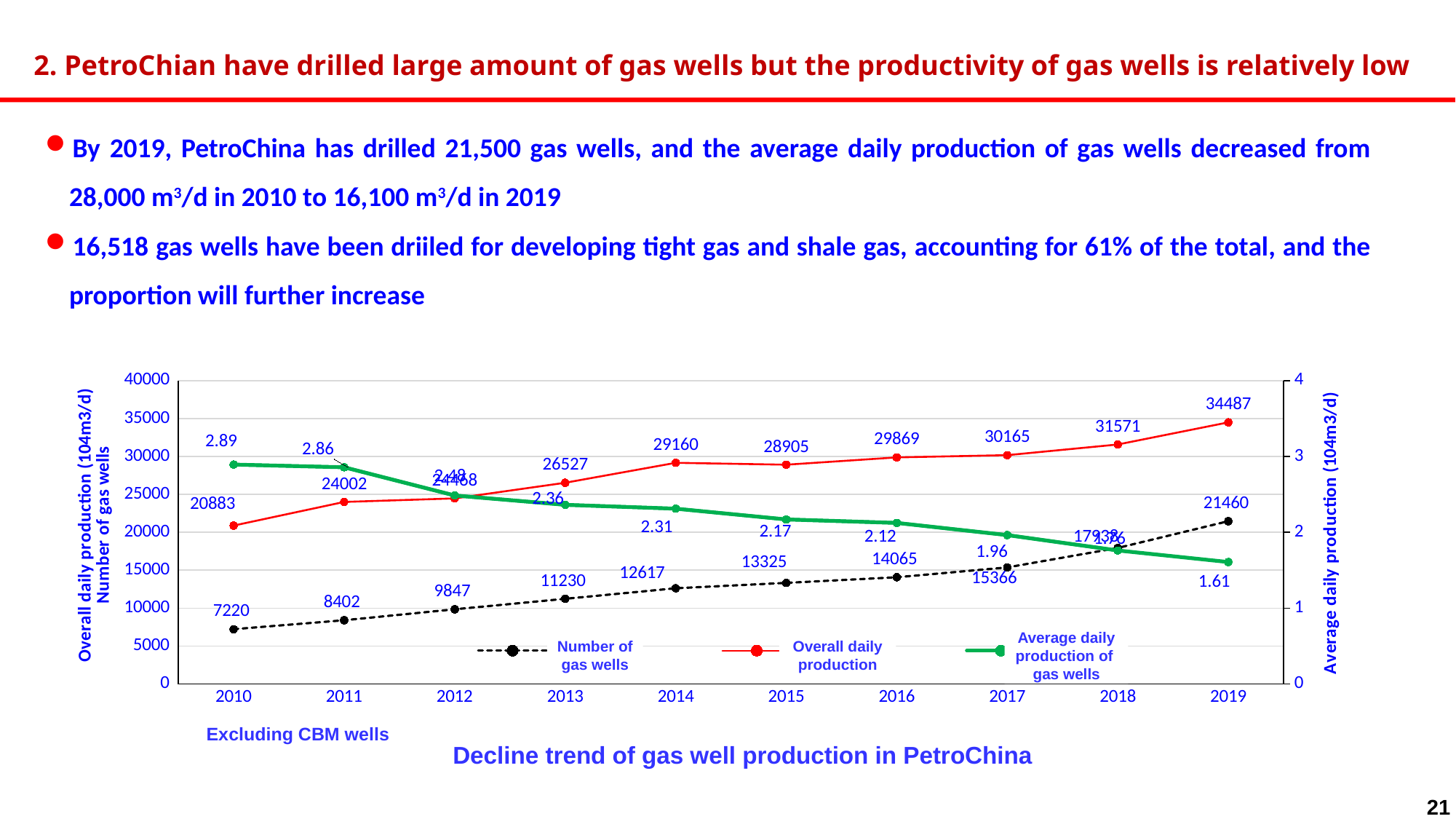
By how much did the number of gas wells increase from 2010 to 2019? 14240 Is the number of gas wells in 2016 greater or less than 15000? less In which year is the average daily production of gas wells lowest? 2019 What is the difference between the average daily production of gas wells in 2010 and in 2019? 1.28 What kind of chart is shown on the slide? line chart Which year has the higher overall daily production, 2014 or 2015? 2014 How many years are shown on the x axis of the chart? 10 What is the overall daily production in 2019? 34487 In which year is the overall daily production highest? 2019 How many series does the chart's legend list? 3 What is the number of gas wells in 2010? 7220 What is the average daily production of gas wells in 2017? 1.96